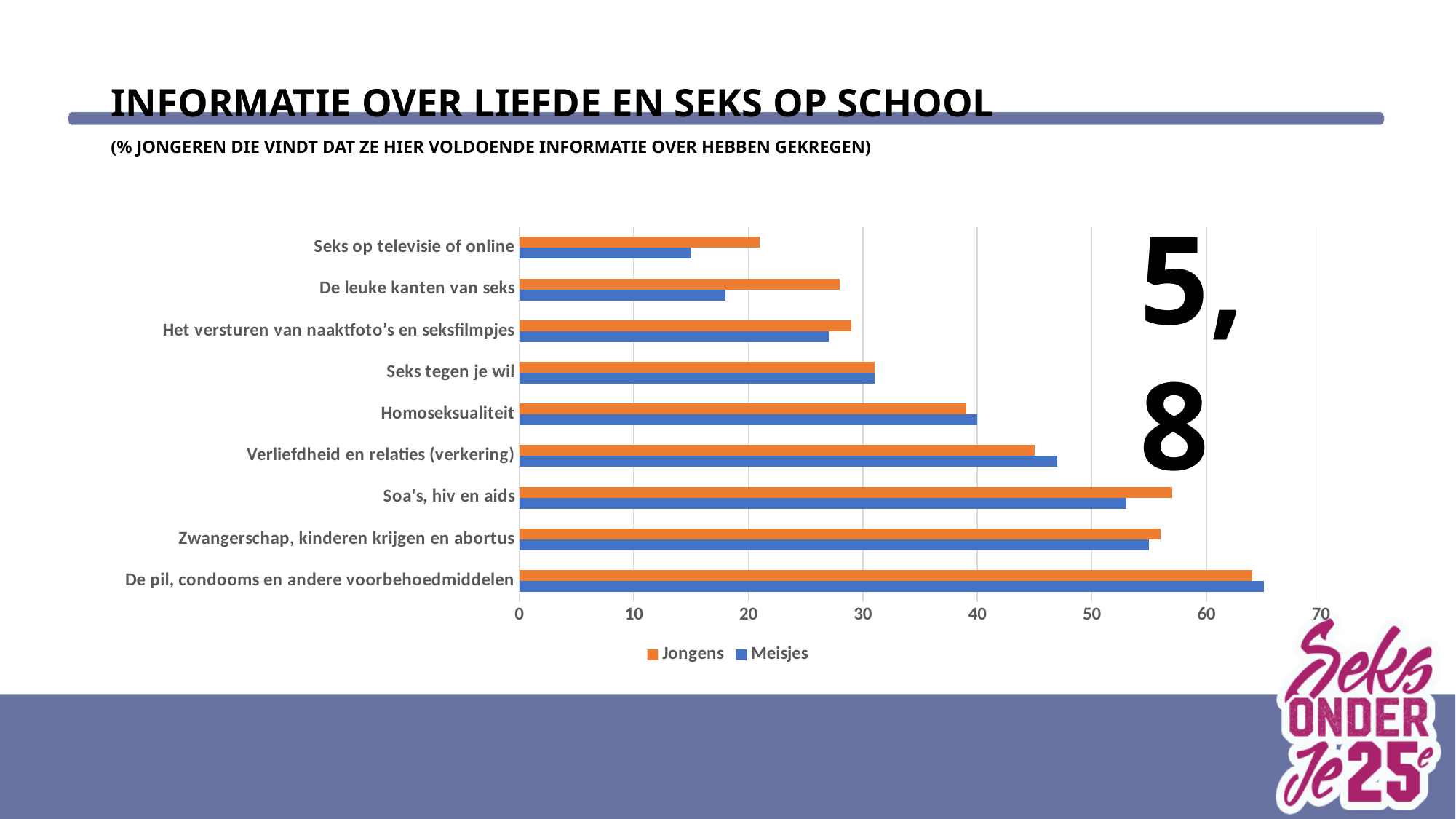
Is the value for Meisjes for 'Verliefdheid en relaties (verkering)' greater or less than 40? greater Is the value for Jongens for 'Soa's, hiv en aids' greater or less than 50? greater How many series does the legend list? 2 Which category has the lowest value for Meisjes? Seks op televisie of online Is the value for Meisjes for 'Seks op televisie of online' greater or less than 20? less Which category has the highest value for Jongens? De pil, condooms en andere voorbehoedmiddelen What kind of chart is shown on the slide? bar chart For 'De leuke kanten van seks', which is larger: the value for Jongens or for Meisjes? Jongens Which colour represents Meisjes in the chart? blue For 'Soa's, hiv en aids', which is larger: the value for Jongens or for Meisjes? Jongens How many categories are shown on the chart? 9